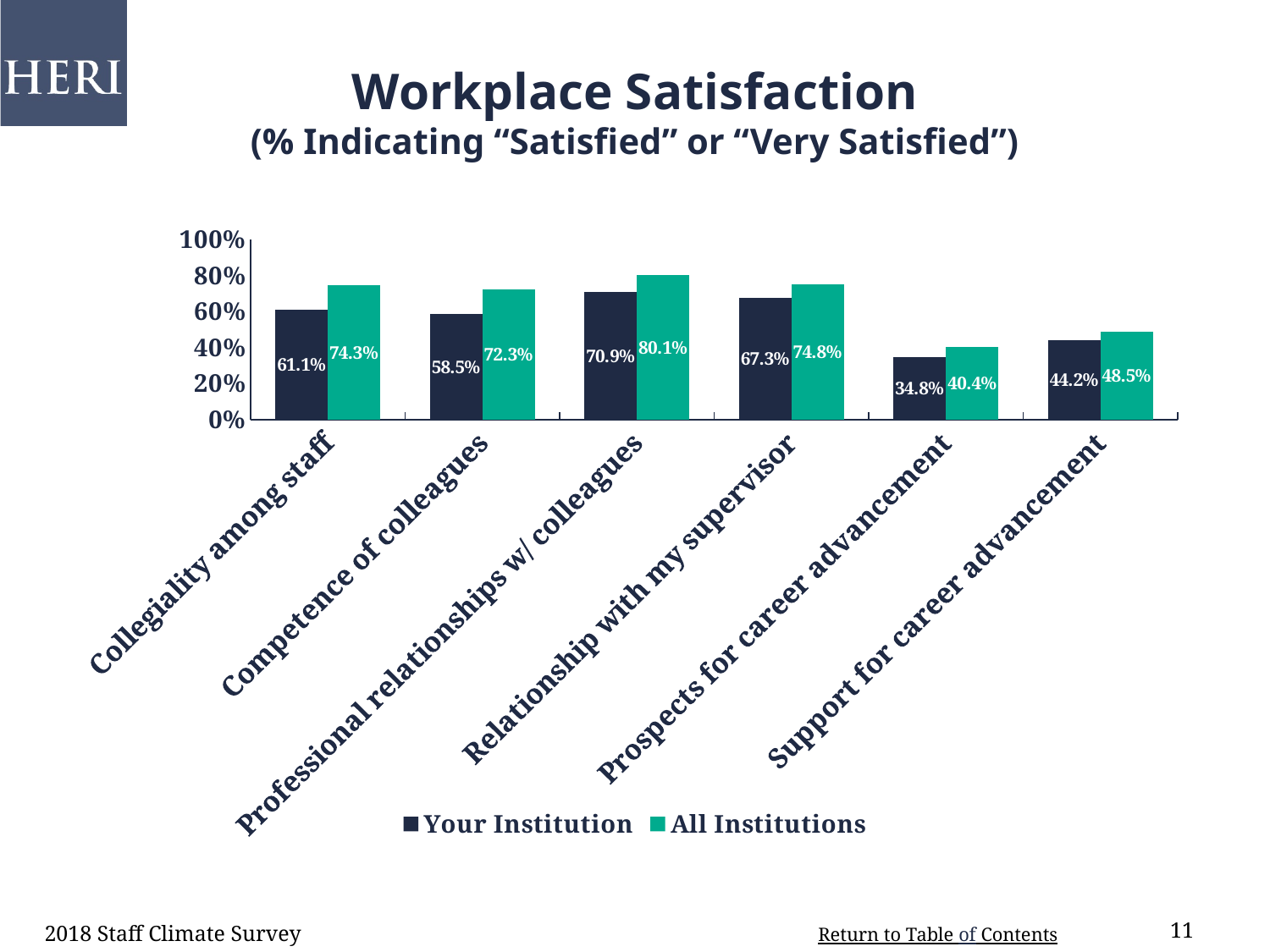
What is the title of the chart? Workplace Satisfaction Which category has the lowest value for Your Institution? Prospects for career advancement How many series does the legend list? 2 Is the value for Your Institution for Support for career advancement greater or less than 60%? less What is the value for All Institutions for Professional relationships w/ colleagues? 80.1% How many categories are shown on the x axis? 6 What is the difference between All Institutions and Your Institution for Competence of colleagues? 13.8% What is the value for Your Institution for Prospects for career advancement? 34.8% What kind of chart is shown on the slide? bar chart What is the value for Your Institution for Collegiality among staff? 61.1% Which category has the highest value for All Institutions? Professional relationships w/ colleagues For Relationship with my supervisor, which is larger: Your Institution or All Institutions? All Institutions